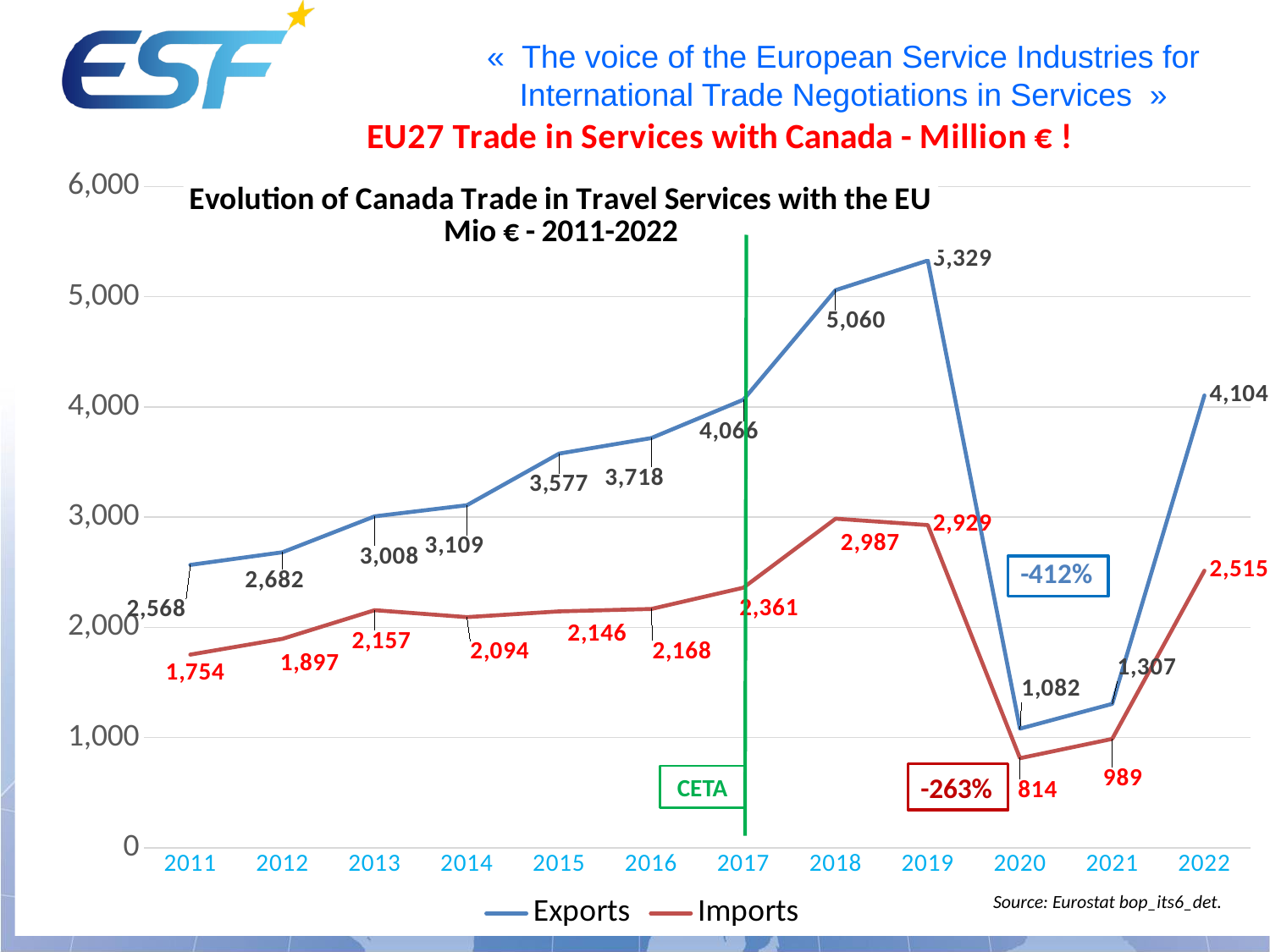
What is the difference between Exports and Imports in 2017? 1,705 What is the value of Imports in 2022? 2,515 What label is shown in the green box next to the vertical green line? CETA How many years are shown on the x axis? 12 What type of chart is shown on the slide? line chart In which year are Imports lowest? 2020 In which year are Exports highest? 2019 What is the value of Imports in 2020? 814 Which is larger in 2021, Exports or Imports? Exports How many series does the legend list? 2 Do Exports rise or fall from 2011 to 2017? rise What is the value of Exports in 2018? 5,060